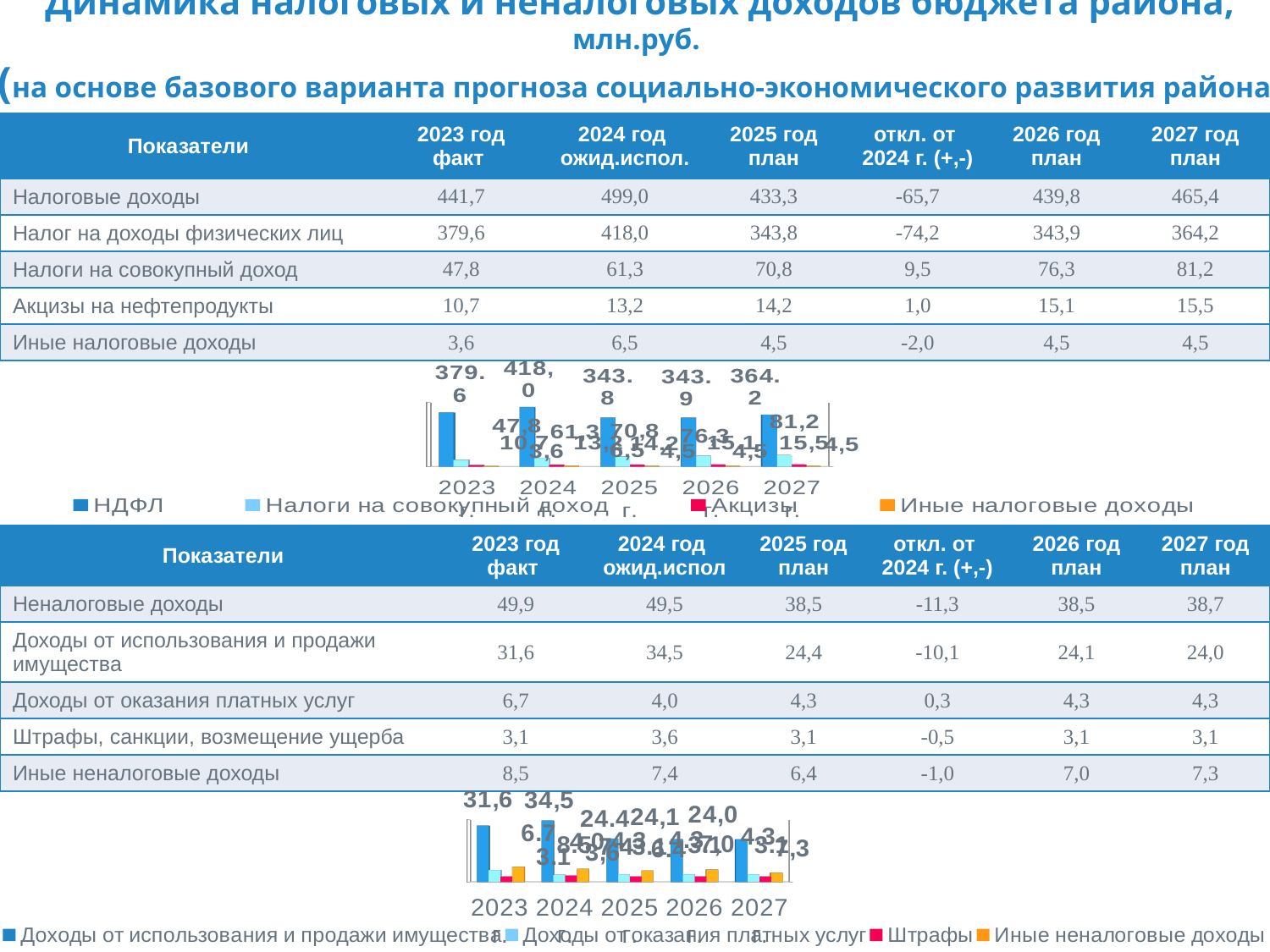
In the upper chart, which year has the highest НДФЛ value? 2024 In the upper chart, what is the value of НДФЛ for 2027? 364,2 In the lower chart, which series is shown in orange in the legend? Иные неналоговые доходы In the upper chart, what is the value of НДФЛ for 2024? 418,0 In the lower chart, what is the difference between the Доходы от использования и продажи имущества values for 2023 and 2024? 2,9 What type of chart is the upper chart? bar chart In the lower chart, which is larger for 2023: Доходы от использования и продажи имущества or Доходы от оказания платных услуг? Доходы от использования и продажи имущества In the lower chart, which year has the highest value for Доходы от использования и продажи имущества? 2024 In the upper chart, how many years are shown on the x axis? 5 In the upper chart, how many series does the legend list? 4 In the lower chart, what is the value of Доходы от использования и продажи имущества for 2024? 34,5 In the upper chart, what is the difference between the НДФЛ values for 2024 and 2025? 74,2